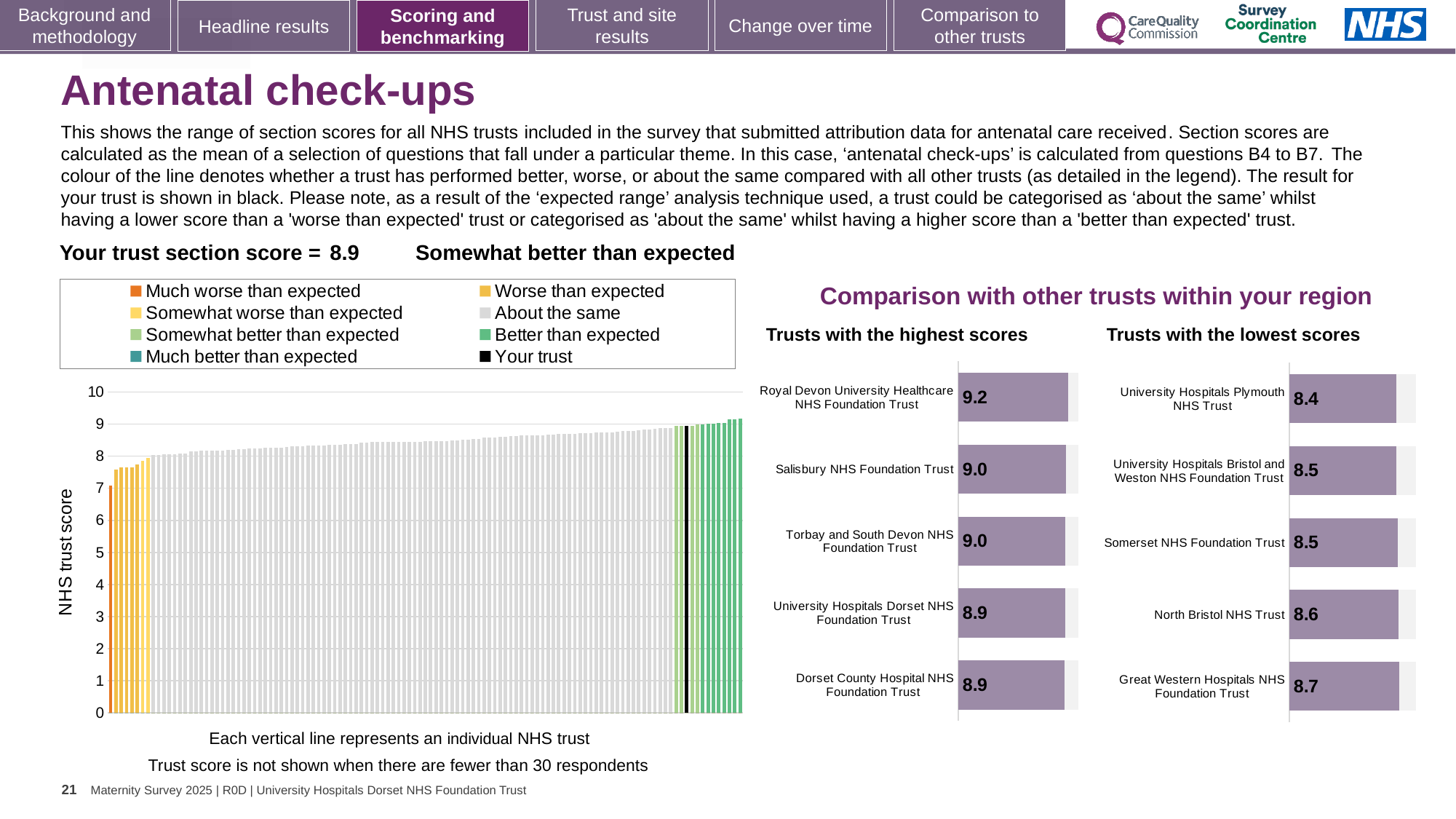
In the 'Trusts with the highest scores' chart, what is the difference between the scores of Royal Devon University Healthcare NHS Foundation Trust and Dorset County Hospital NHS Foundation Trust? 0.3 How many entries does the legend above the 'NHS trust score' chart list? 8 In the 'NHS trust score' chart on the left, do the values rise or fall from left to right? Rise In the 'Trusts with the highest scores' chart, what is the score for Royal Devon University Healthcare NHS Foundation Trust? 9.2 How many trusts are shown in the 'Trusts with the highest scores' chart? 5 In the 'Trusts with the lowest scores' chart, what is the score for Somerset NHS Foundation Trust? 8.5 In the 'Trusts with the highest scores' chart, which trust has the highest score? Royal Devon University Healthcare NHS Foundation Trust In the 'Trusts with the lowest scores' chart, which has the higher score: North Bristol NHS Trust or Great Western Hospitals NHS Foundation Trust? Great Western Hospitals NHS Foundation Trust In the 'NHS trust score' chart on the left, is the value of the leftmost (orange) bar greater or less than 8? less What kind of chart is the 'NHS trust score' chart on the left of the slide? Bar chart In the 'Trusts with the lowest scores' chart, which trust has the lowest score? University Hospitals Plymouth NHS Trust In the 'Trusts with the lowest scores' chart, what is the score for University Hospitals Plymouth NHS Trust? 8.4